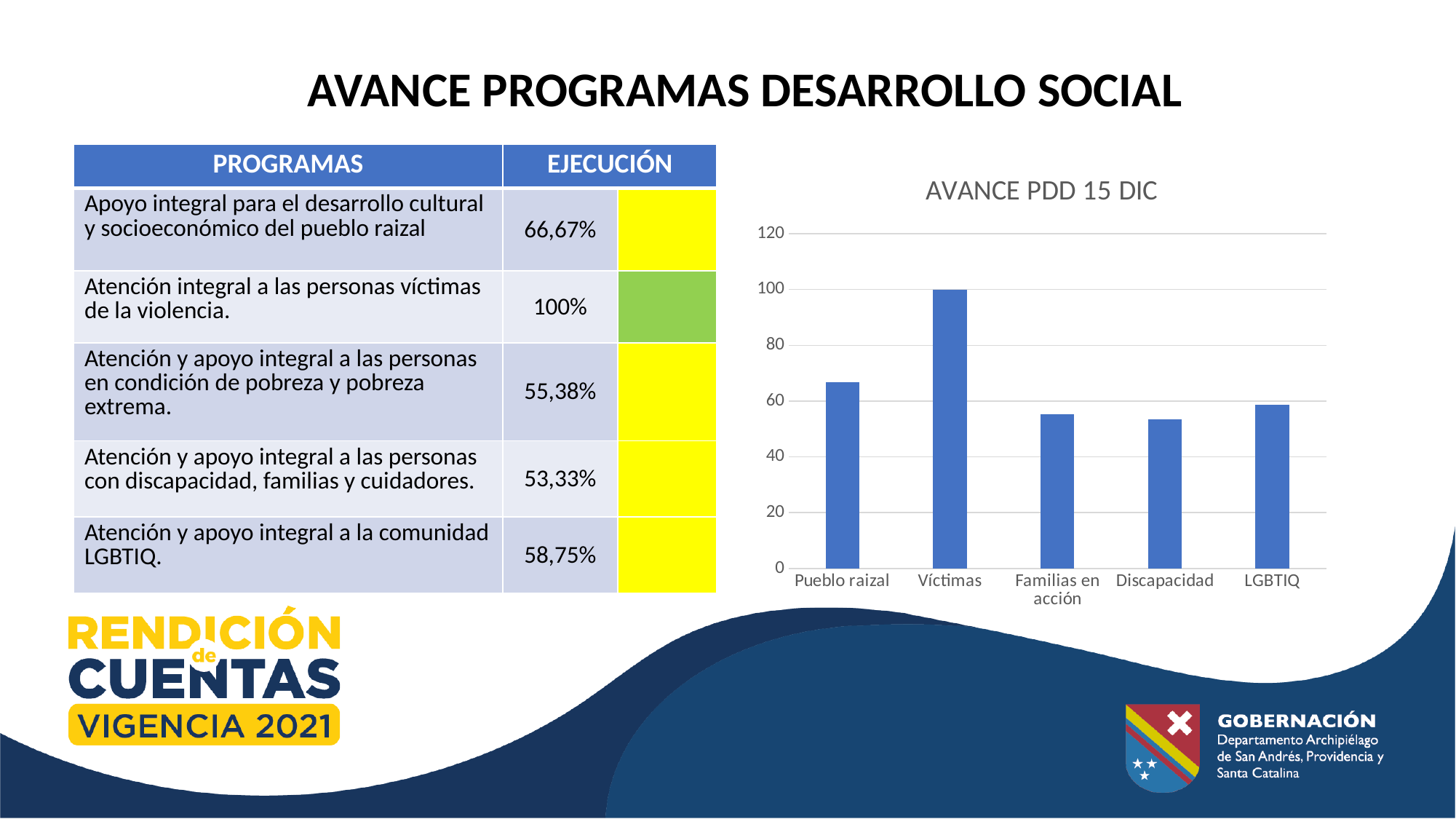
What is the title of the chart? AVANCE PDD 15 DIC Which category has the highest bar in the chart? Víctimas Which is larger, the value for Pueblo raizal or the value for LGBTIQ? Pueblo raizal Is the value for Pueblo raizal greater or less than 60? greater Is the value for Familias en acción greater or less than 60? less What is the highest value shown on the chart's vertical axis? 120 What kind of chart is shown on the slide? bar chart Which is larger, the value for Víctimas or the value for Discapacidad? Víctimas What value does the bar for Víctimas reach on the chart's axis? 100 Is the value for LGBTIQ greater or less than 80? less How many categories are shown on the x axis of the chart? 5